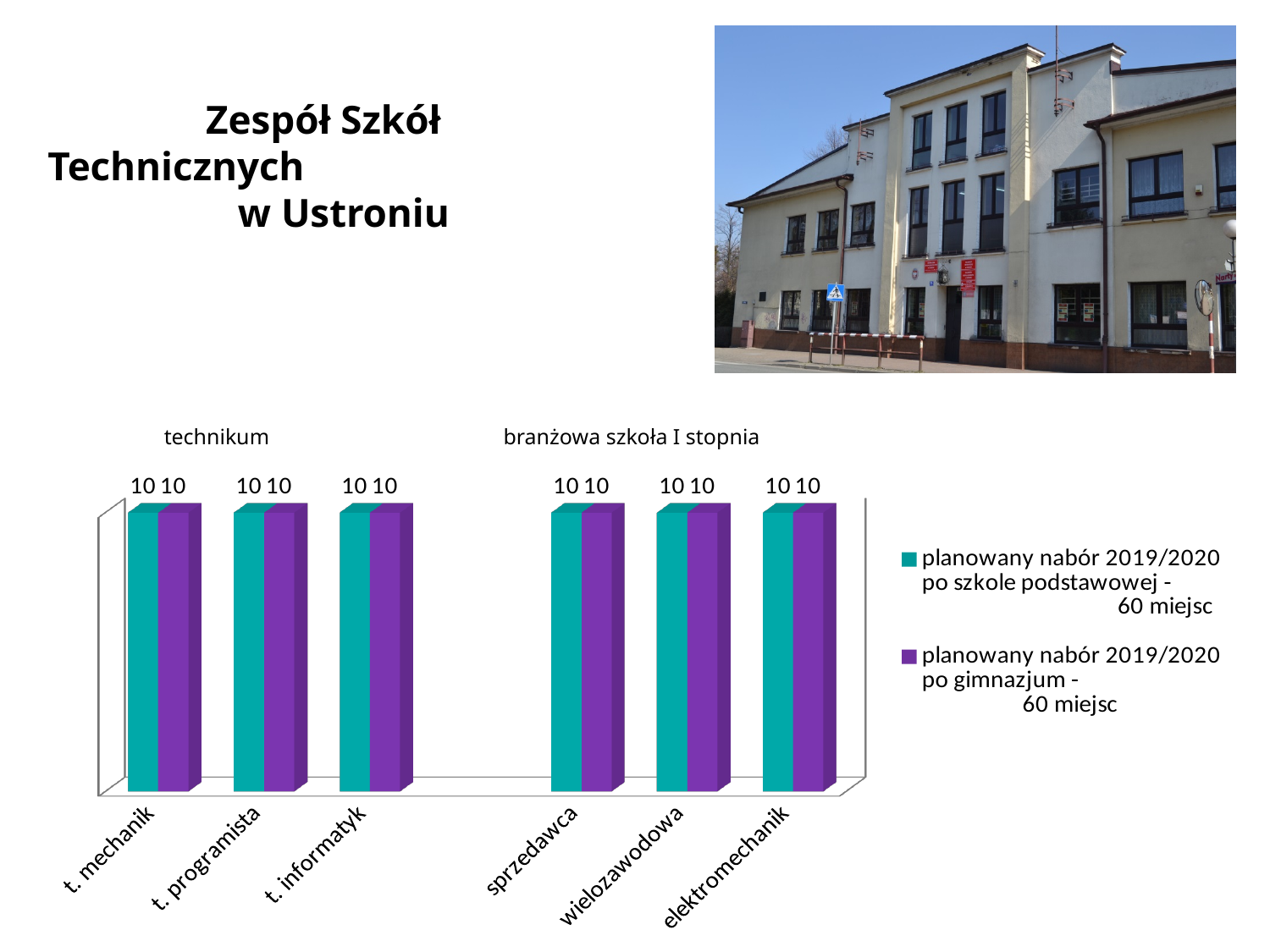
Do the values rise, fall, or stay the same across the categories on the x axis? stay the same What is the planned intake after gimnazjum for sprzedawca? 10 How many categories are shown on the x axis of the chart? 6 Which categories are grouped under the heading 'technikum'? t. mechanik, t. programista, t. informatyk What is the value for wielozawodowa in the 'planowany nabór 2019/2020 po szkole podstawowej' series? 10 What is the difference between the two series values for t. programista? 0 What kind of chart is shown on the slide? bar chart What is the value for elektromechanik in the 'planowany nabór 2019/2020 po gimnazjum' series? 10 What is the planned intake after primary school (po szkole podstawowej) for t. mechanik? 10 How many series does the chart legend list? 2 What is the value for t. informatyk in the 'planowany nabór 2019/2020 po szkole podstawowej' series? 10 Which colour represents the 'planowany nabór 2019/2020 po gimnazjum' series? purple